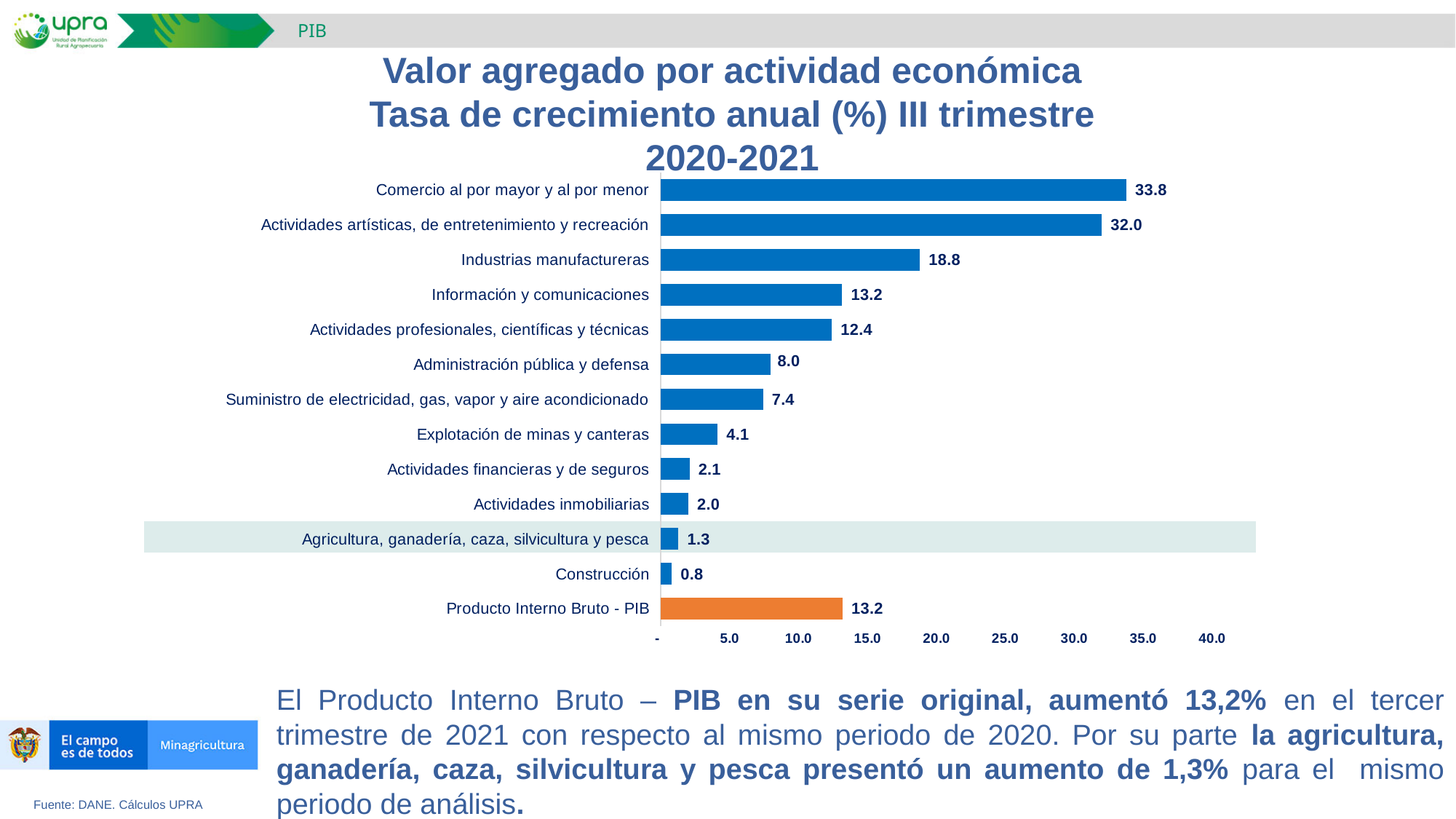
Which category has the lowest value? Construcción What is the value for Comercio al por mayor y al por menor? 33.8 Which bar is shown in orange rather than blue? Producto Interno Bruto - PIB What is the value for Producto Interno Bruto - PIB? 13.2 What is the value for Agricultura, ganadería, caza, silvicultura y pesca? 1.3 What is the difference between the values for Comercio al por mayor y al por menor and Actividades artísticas, de entretenimiento y recreación? 1.8 Which is larger, the value for Administración pública y defensa or the value for Suministro de electricidad, gas, vapor y aire acondicionado? Administración pública y defensa Which category has the highest value? Comercio al por mayor y al por menor How many categories are shown in the chart? 13 Is the value for Explotación de minas y canteras greater or less than 5.0? less What kind of chart is shown on the slide? bar chart What is the value for Industrias manufactureras? 18.8